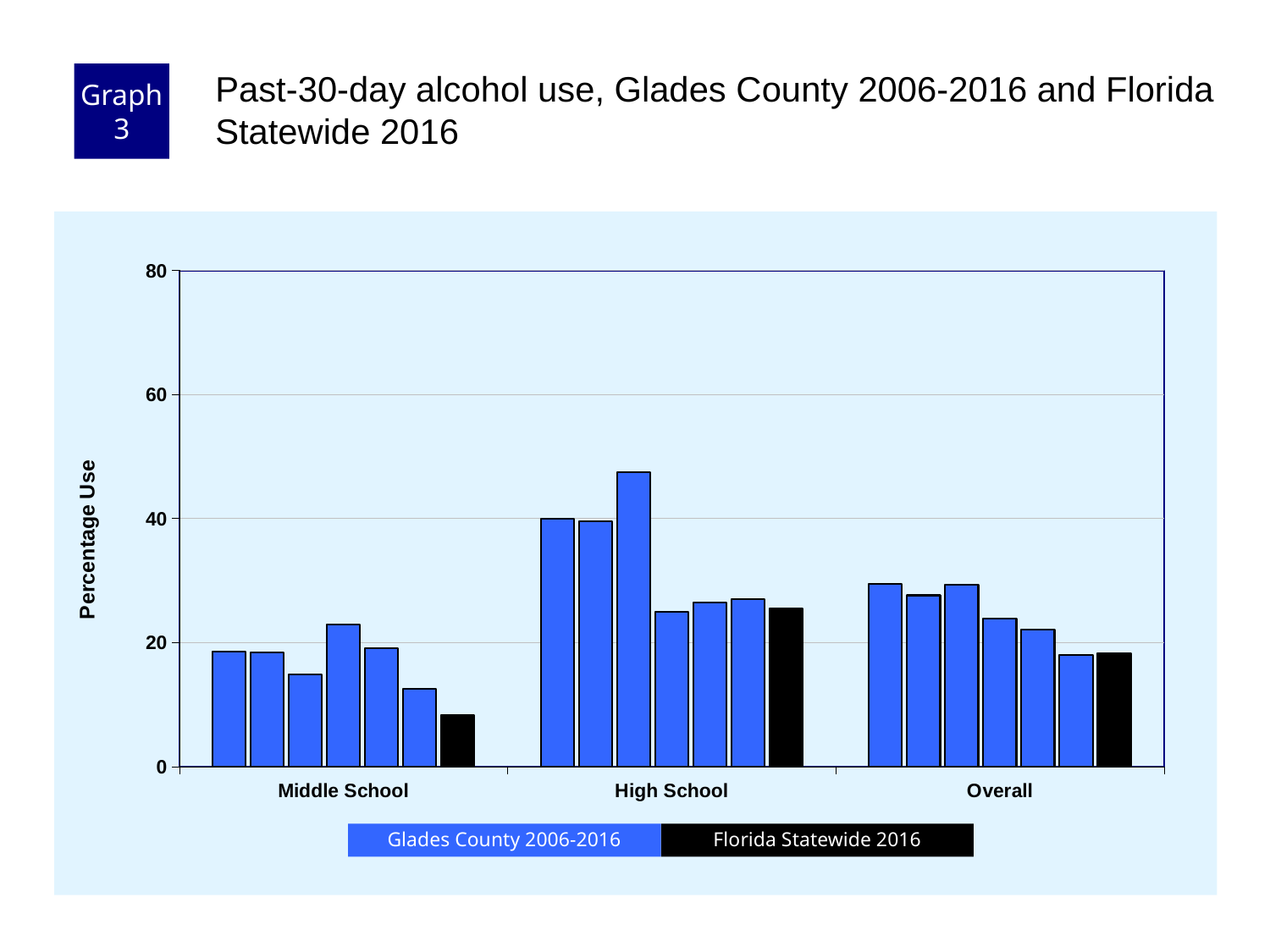
How many series does the legend list? 2 What kind of chart is shown on the slide? bar chart What is the title of the y axis? Percentage Use How many categories are shown on the x axis? 3 Is the Florida Statewide 2016 value for High School greater or less than 20? greater Which is larger: the Florida Statewide 2016 value for High School or for Middle School? High School Is the Florida Statewide 2016 value for Middle School greater or less than 20? less Which category has the highest Florida Statewide 2016 value? High School Is the tallest Glades County 2006-2016 bar for High School greater or less than 40? greater What colour are the Florida Statewide 2016 bars? black Which category has the lowest Florida Statewide 2016 value? Middle School